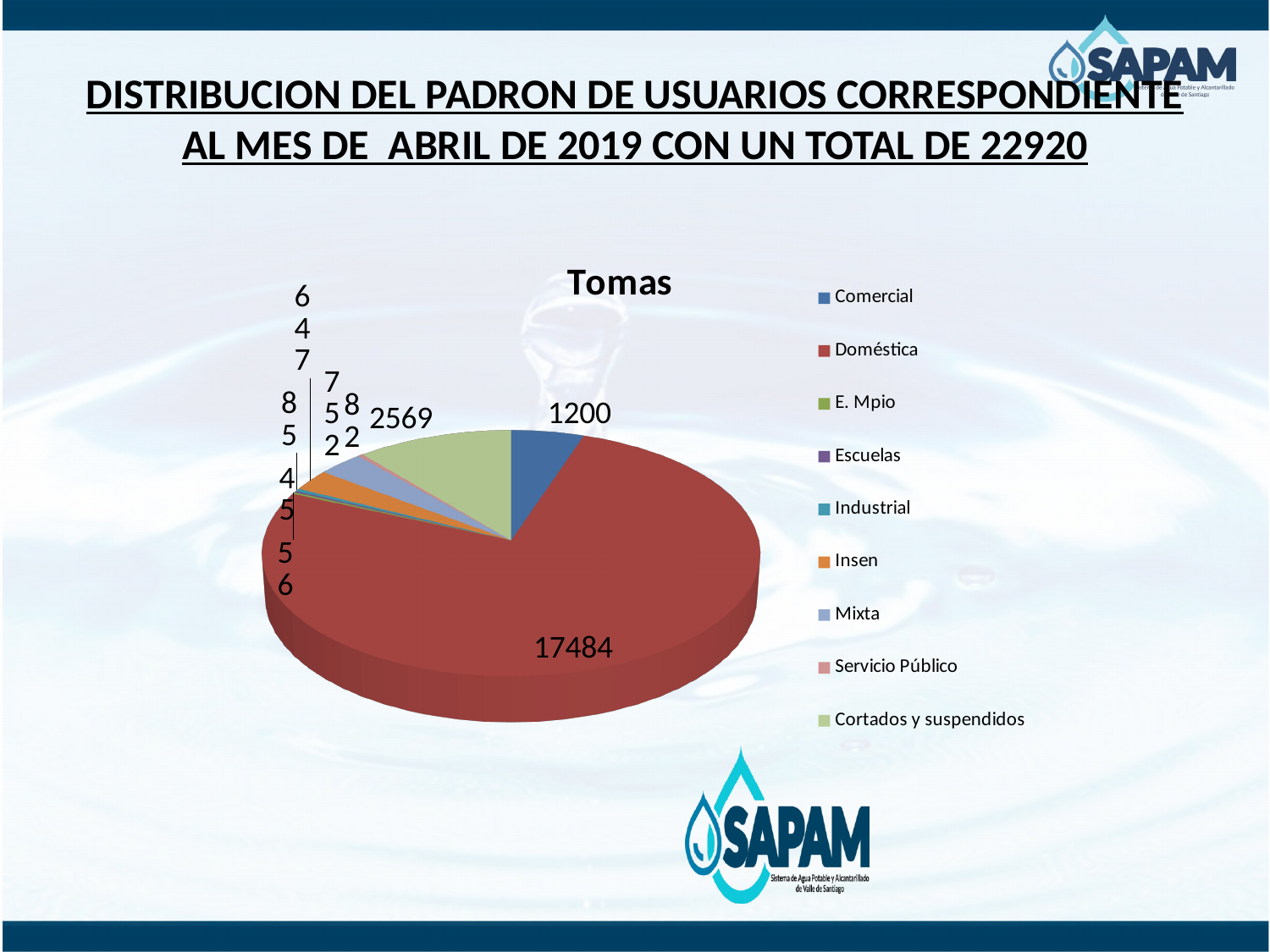
Which is larger, the Doméstica slice or the Comercial slice? Doméstica How many categories does the legend of the pie chart list? 9 What is the value shown for Doméstica in the pie chart? 17484 Is the value for Comercial greater or less than 2000? less What is the value shown for Comercial in the pie chart? 1200 Which is larger, the Comercial slice (1200) or the slice labelled 2569? the slice labelled 2569 Which category has the largest slice in the pie chart? Doméstica What total number of users is stated in the slide title? 22920 What is the title of the pie chart? Tomas What kind of chart is shown on the slide? pie chart What is the difference between the Doméstica value and the Comercial value? 16284